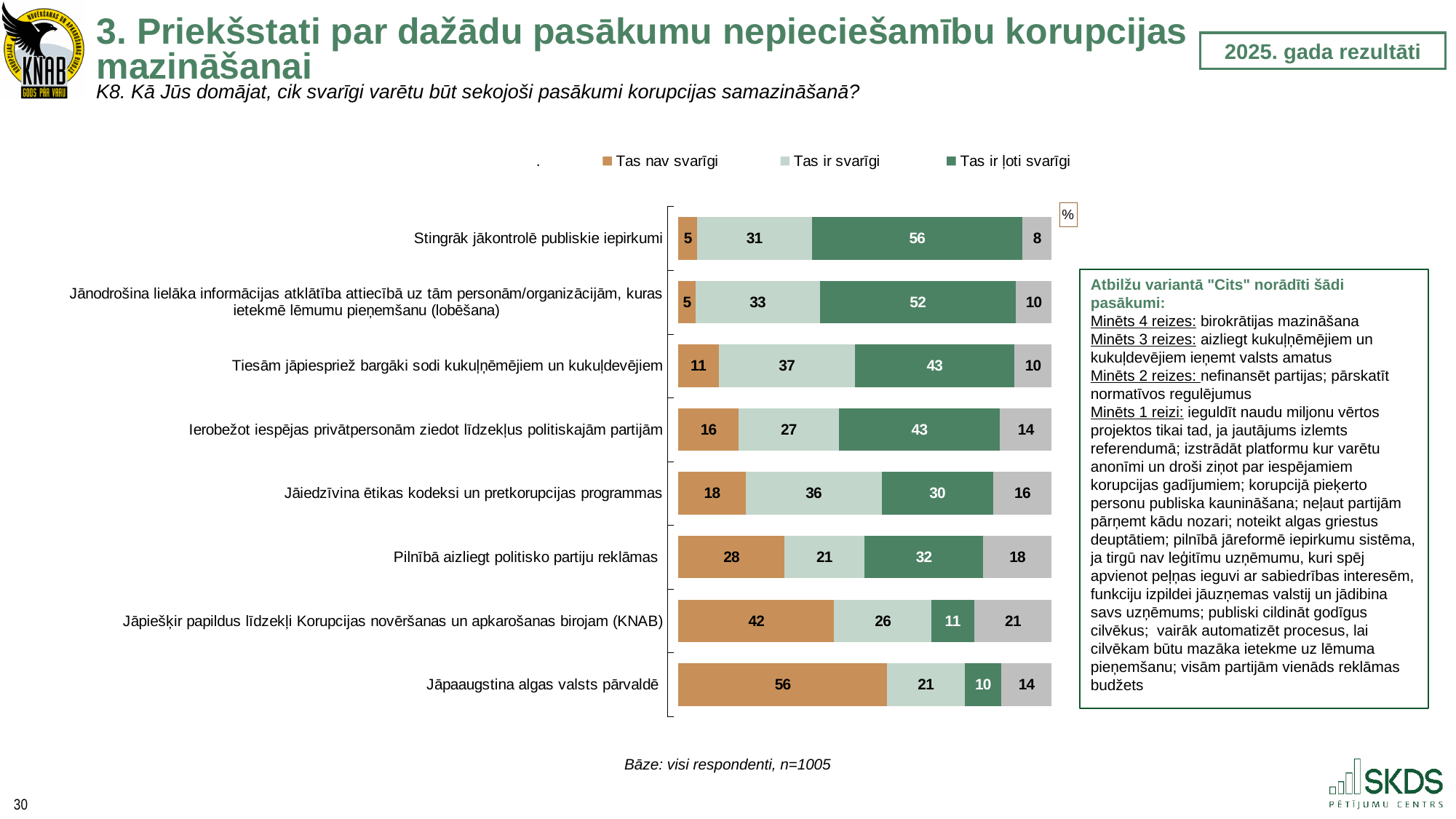
Which measure has the highest value for "Tas ir ļoti svarīgi"? Stingrāk jākontrolē publiskie iepirkumi How many series does the chart legend list? 3 What is the value of "Tas ir ļoti svarīgi" for "Stingrāk jākontrolē publiskie iepirkumi"? 56 Which measure has the lowest value for "Tas ir ļoti svarīgi"? Jāpaaugstina algas valsts pārvaldē What is the difference between the "Tas nav svarīgi" values for "Jāpiešķir papildus līdzekļi Korupcijas novēršanas un apkarošanas birojam (KNAB)" and "Pilnībā aizliegt politisko partiju reklāmas"? 14 What is the base (number of respondents) stated below the chart? n=1005 What is the value of "Tas ir svarīgi" for "Tiesām jāpiespriež bargāki sodi kukuļņēmējiem un kukuļdevējiem"? 37 Which has a larger "Tas ir svarīgi" value: "Jāiedzīvina ētikas kodeksi un pretkorupcijas programmas" or "Ierobežot iespējas privātpersonām ziedot līdzekļus politiskajām partijām"? Jāiedzīvina ētikas kodeksi un pretkorupcijas programmas What kind of chart is shown on the slide? Stacked bar chart How many measures (categories) are plotted in the chart? 8 What is the value of "Tas nav svarīgi" for "Jāpaaugstina algas valsts pārvaldē"? 56 What is the total of all printed segments in the bar for "Stingrāk jākontrolē publiskie iepirkumi"? 100